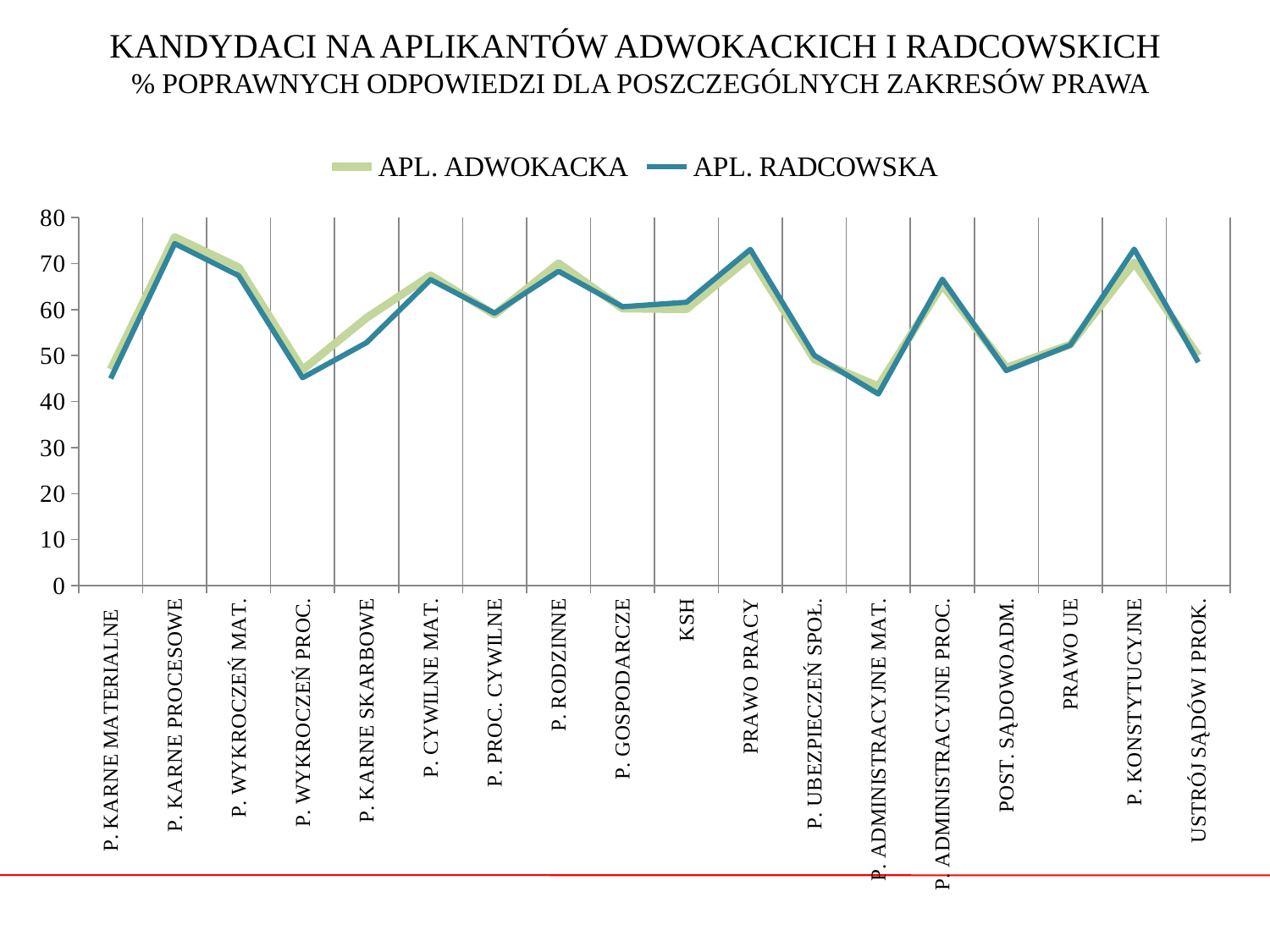
Is the APL. RADCOWSKA value for P. WYKROCZEŃ PROC. greater or less than 50? less Is the APL. ADWOKACKA value for P. KARNE MATERIALNE greater or less than 50? less Is the APL. ADWOKACKA value for P. KARNE PROCESOWE greater or less than 70? greater What kind of chart is shown on the slide? line chart How many series does the legend list? 2 Which category has the highest value for APL. ADWOKACKA? P. KARNE PROCESOWE How many categories are plotted along the x axis? 18 For P. KARNE SKARBOWE, which series has the larger value, APL. ADWOKACKA or APL. RADCOWSKA? APL. ADWOKACKA Which series is drawn in the light green line? APL. ADWOKACKA Which category has the lowest value for APL. RADCOWSKA? P. ADMINISTRACYJNE MAT. Do the values for APL. RADCOWSKA rise or fall from P. KARNE PROCESOWE to P. WYKROCZEŃ PROC.? fall